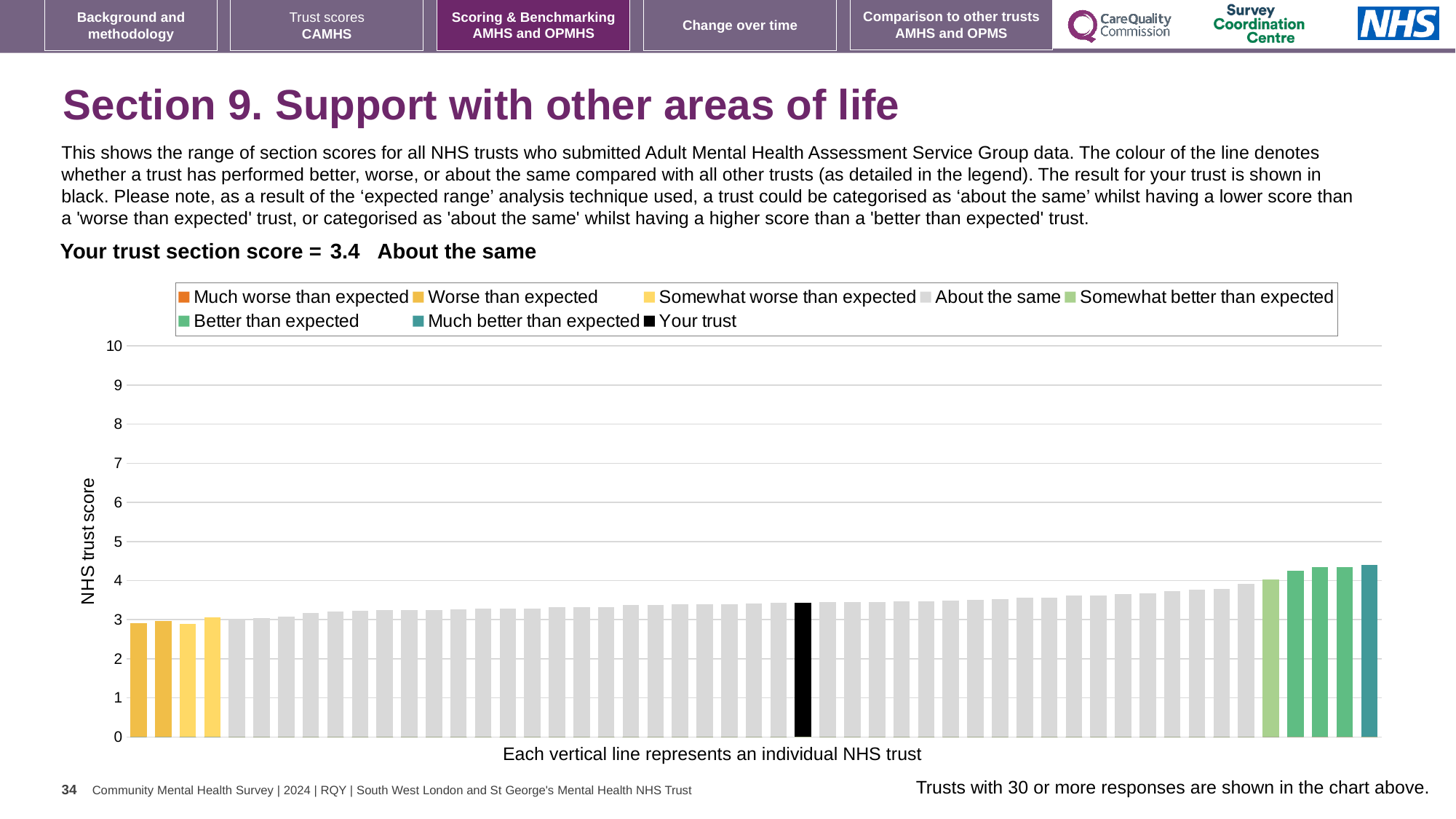
Is the value of the black bar (your trust) greater or less than 3? greater How many entries does the chart legend list? 8 Is the value of the tallest bar in the chart greater or less than 4? greater What is the section score for your trust shown on the slide? 3.4 Do the bar values rise or fall from left to right along the x axis? rise What kind of chart is shown on the slide? bar chart What is the highest value shown on the vertical axis? 10 Is the value of the tallest bar in the chart greater or less than 5? less What colour is used in the legend for 'Your trust'? black What is the label on the vertical axis of the chart? NHS trust score Which performance category is your trust placed in for this section? About the same